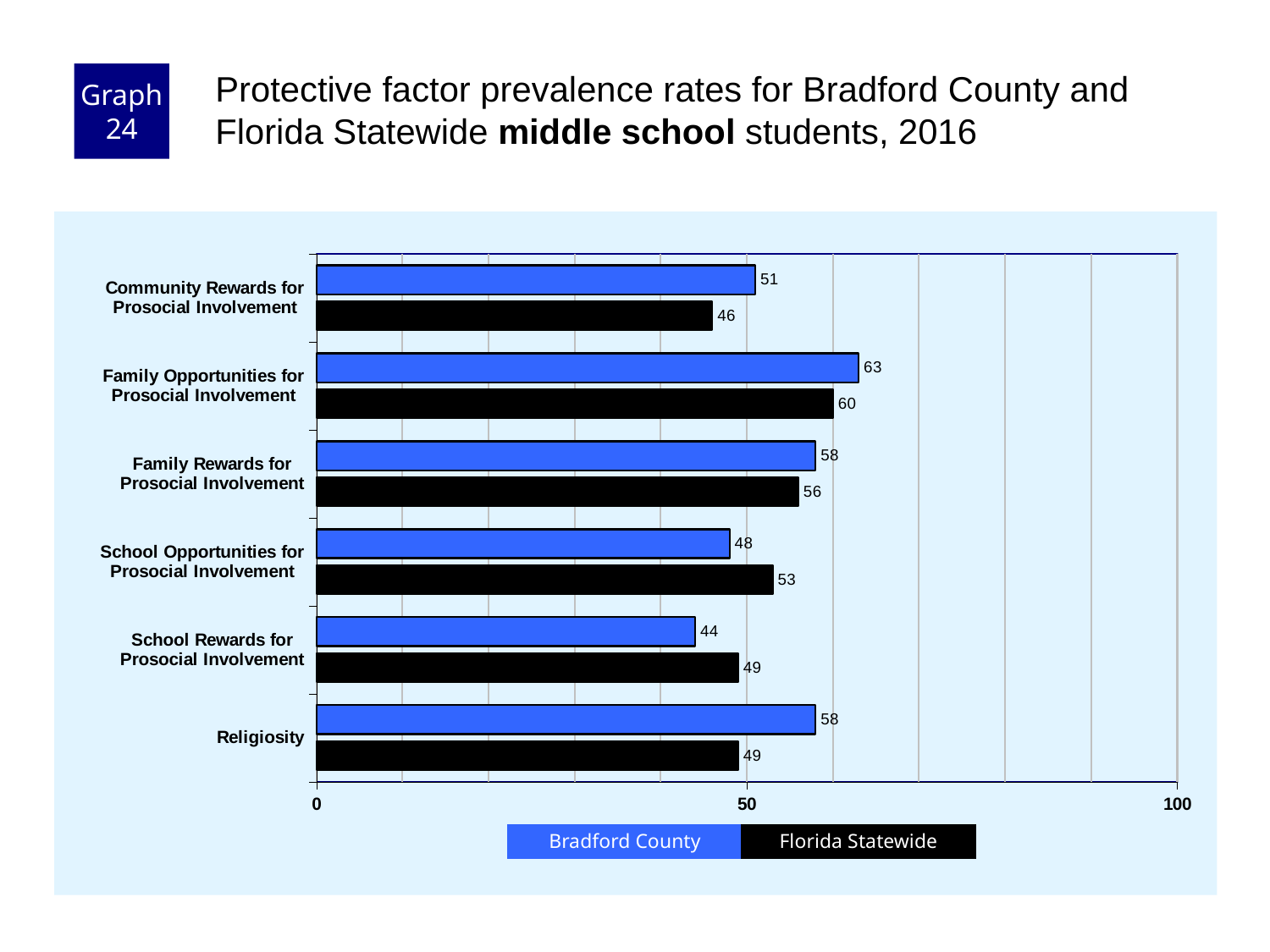
Which category has the lowest Florida Statewide value? Community Rewards for Prosocial Involvement What is the difference between the Bradford County and Florida Statewide values for Religiosity? 9 How many categories are shown on the chart? 6 Is the Bradford County value for School Rewards for Prosocial Involvement greater or less than 50? less What is the Florida Statewide value for School Rewards for Prosocial Involvement? 49 What is the Florida Statewide value for Community Rewards for Prosocial Involvement? 46 How many series does the legend list? 2 What is the Bradford County value for Family Opportunities for Prosocial Involvement? 63 What kind of chart is shown on the slide? bar chart For School Opportunities for Prosocial Involvement, which is larger: Bradford County or Florida Statewide? Florida Statewide Which category has the lowest Bradford County value? School Rewards for Prosocial Involvement Which category has the highest Bradford County value? Family Opportunities for Prosocial Involvement